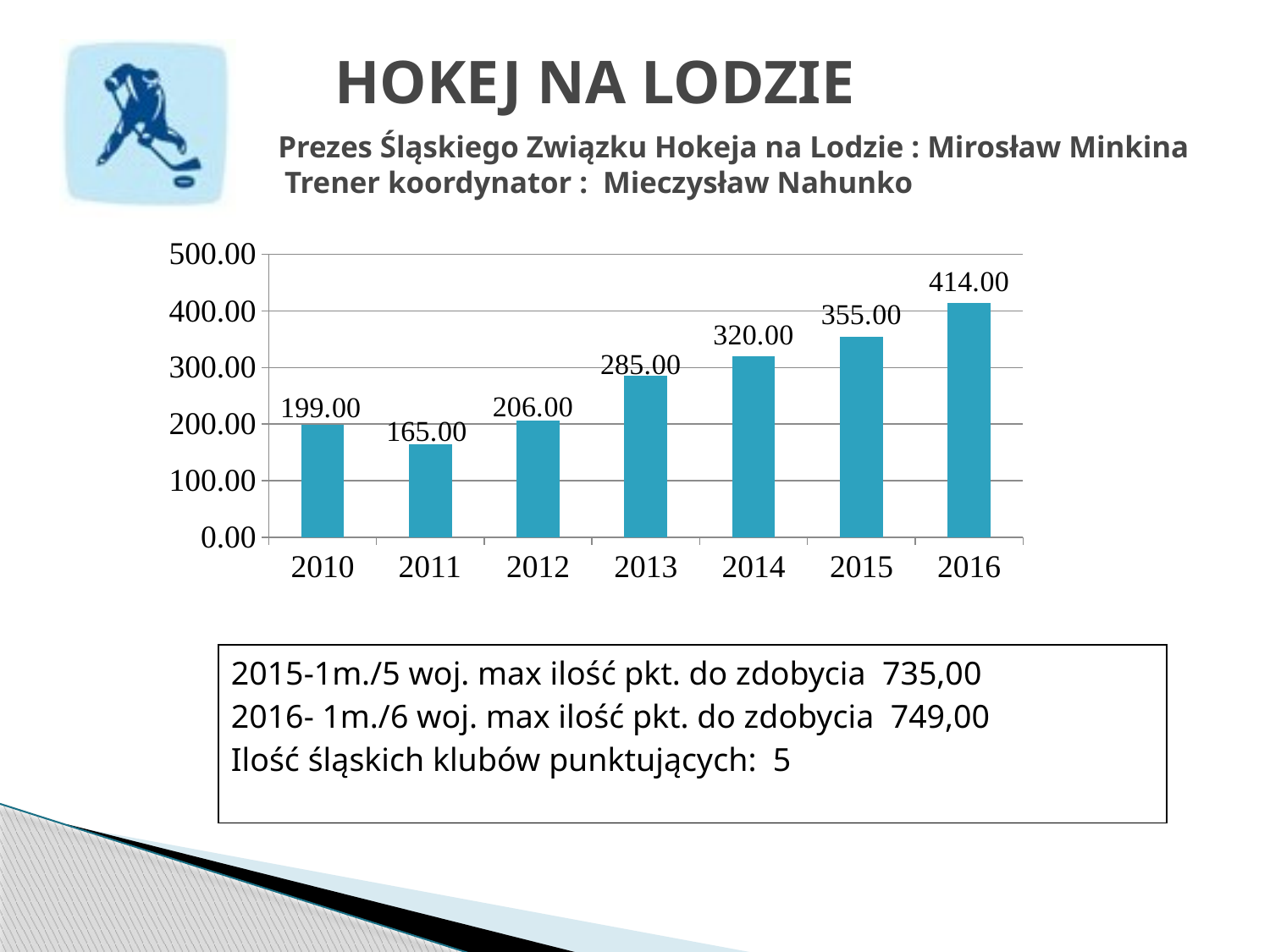
What is the value shown for 2010? 199.00 How many years are shown on the x axis? 7 What is the value shown for 2016? 414.00 Which year has the lowest value? 2011 Do the values generally rise or fall from 2011 to 2016? rise What is the difference between the values for 2012 and 2011? 41.00 What is the difference between the values for 2016 and 2015? 59.00 What kind of chart is shown on the slide? bar chart Which is larger, the value for 2014 or the value for 2013? 2014 What is the value shown for 2013? 285.00 Which year has the highest value? 2016 Is the value for 2015 greater or less than 300.00? greater